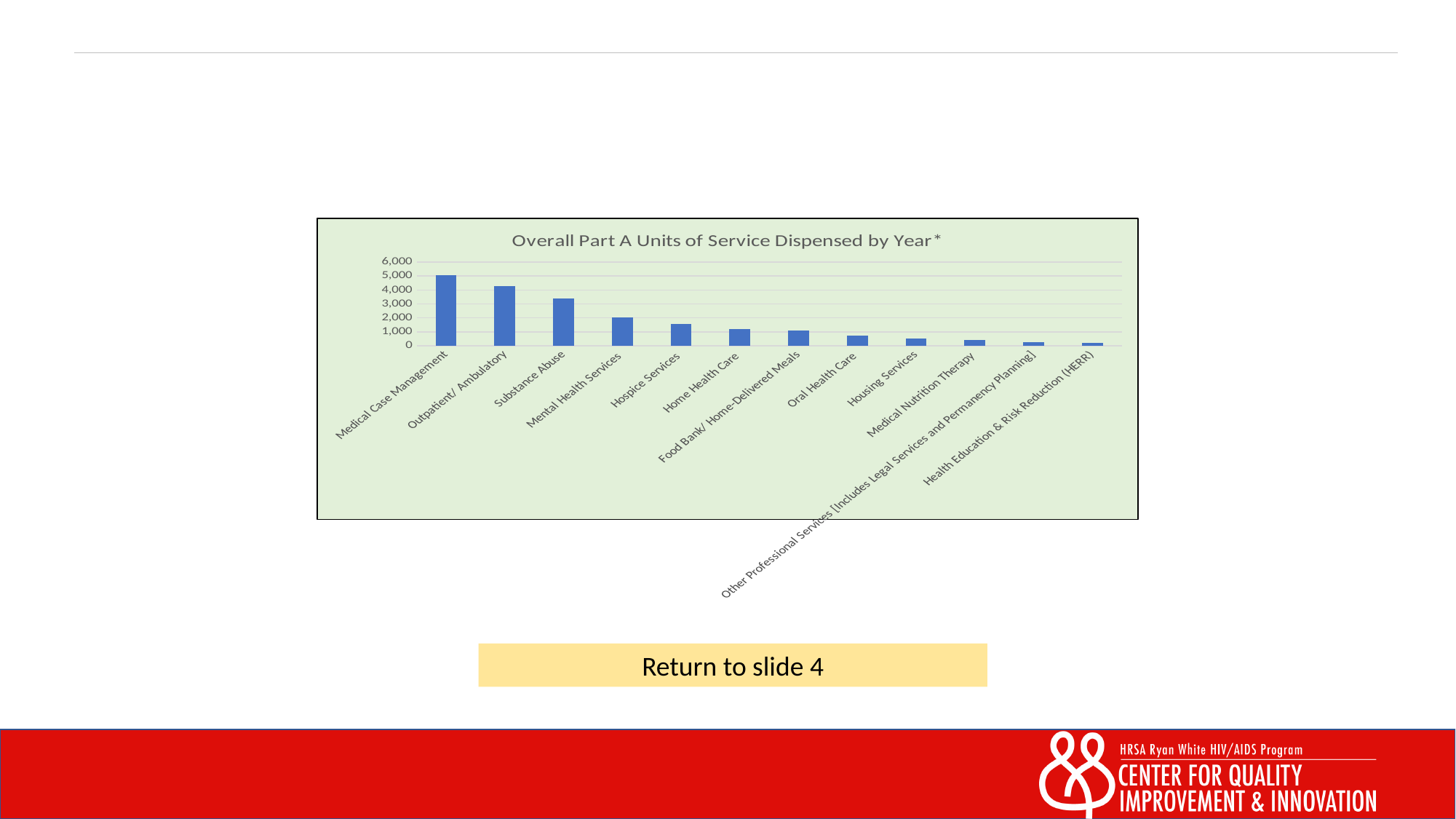
Do the bar values rise or fall moving from left to right along the x axis? Fall How many service categories are shown on the x axis of the chart? 12 Is the value for Hospice Services greater or less than 2,000? less What kind of chart is shown on the slide? Bar chart Which has more units of service, Housing Services or Home Health Care? Home Health Care Which service category has the lowest number of units of service? Health Education & Risk Reduction (HERR) Is the value for Oral Health Care greater or less than 1,000? less Is the value for Substance Abuse greater or less than 3,000? greater Which service category has the highest number of units of service? Medical Case Management What is the title of the chart? Overall Part A Units of Service Dispensed by Year* Which has more units of service, Substance Abuse or Mental Health Services? Substance Abuse